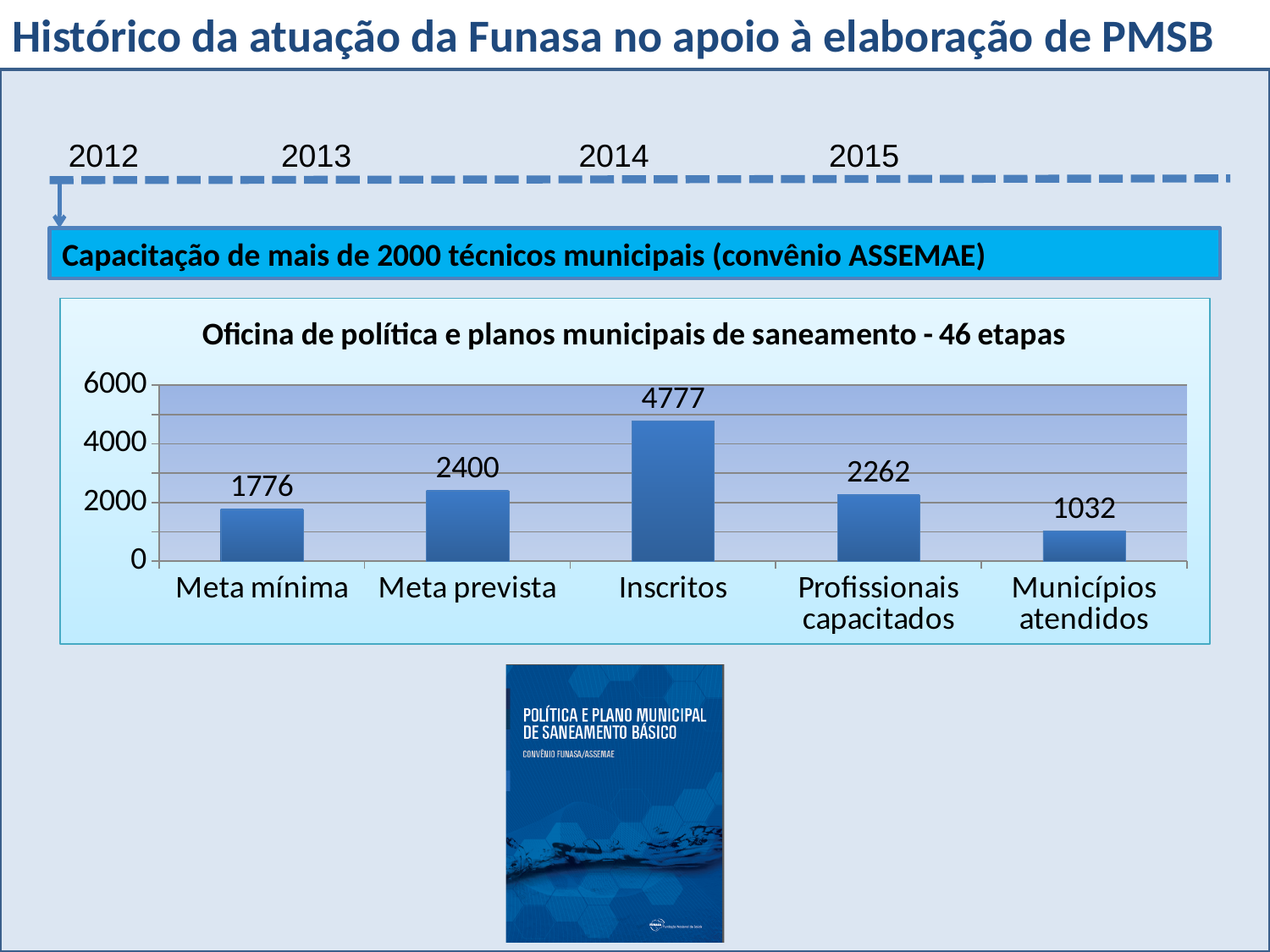
What is the value for Meta mínima? 1776 What kind of chart is shown on the slide? Bar chart What is the title of the chart? Oficina de política e planos municipais de saneamento - 46 etapas What is the value for Inscritos? 4777 Which category has the highest value? Inscritos Which is larger, Meta prevista or Profissionais capacitados? Meta prevista What is the difference between Inscritos and Profissionais capacitados? 2515 Which category has the lowest value? Municípios atendidos What is the value for Municípios atendidos? 1032 What is the value for Profissionais capacitados? 2262 How many categories are shown in the chart? 5 What is the difference between Meta prevista and Meta mínima? 624